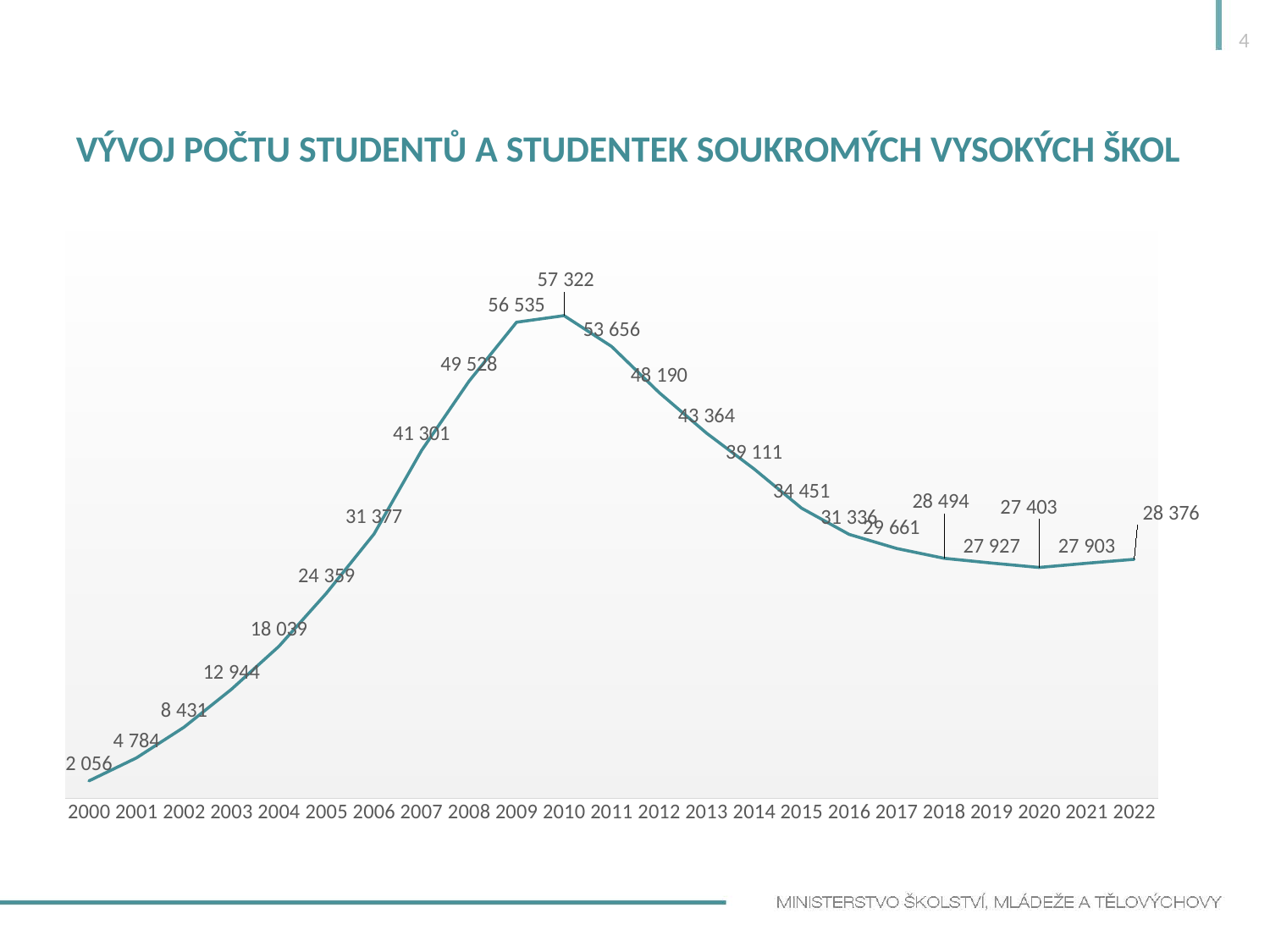
How many years are plotted on the x axis? 23 What is the value for 2010? 57 322 What is the value for 2022? 28 376 What is the title of the chart? VÝVOJ POČTU STUDENTŮ A STUDENTEK SOUKROMÝCH VYSOKÝCH ŠKOL What is the value for 2000? 2 056 Which is larger, the value for 2007 or the value for 2013? 2013 Which year has the lowest value? 2000 Do the values rise or fall between 2000 and 2010? rise Which year has the highest value? 2010 What is the difference between the values for 2010 and 2009? 787 What type of chart is shown on the slide? line chart What is the value for 2015? 34 451